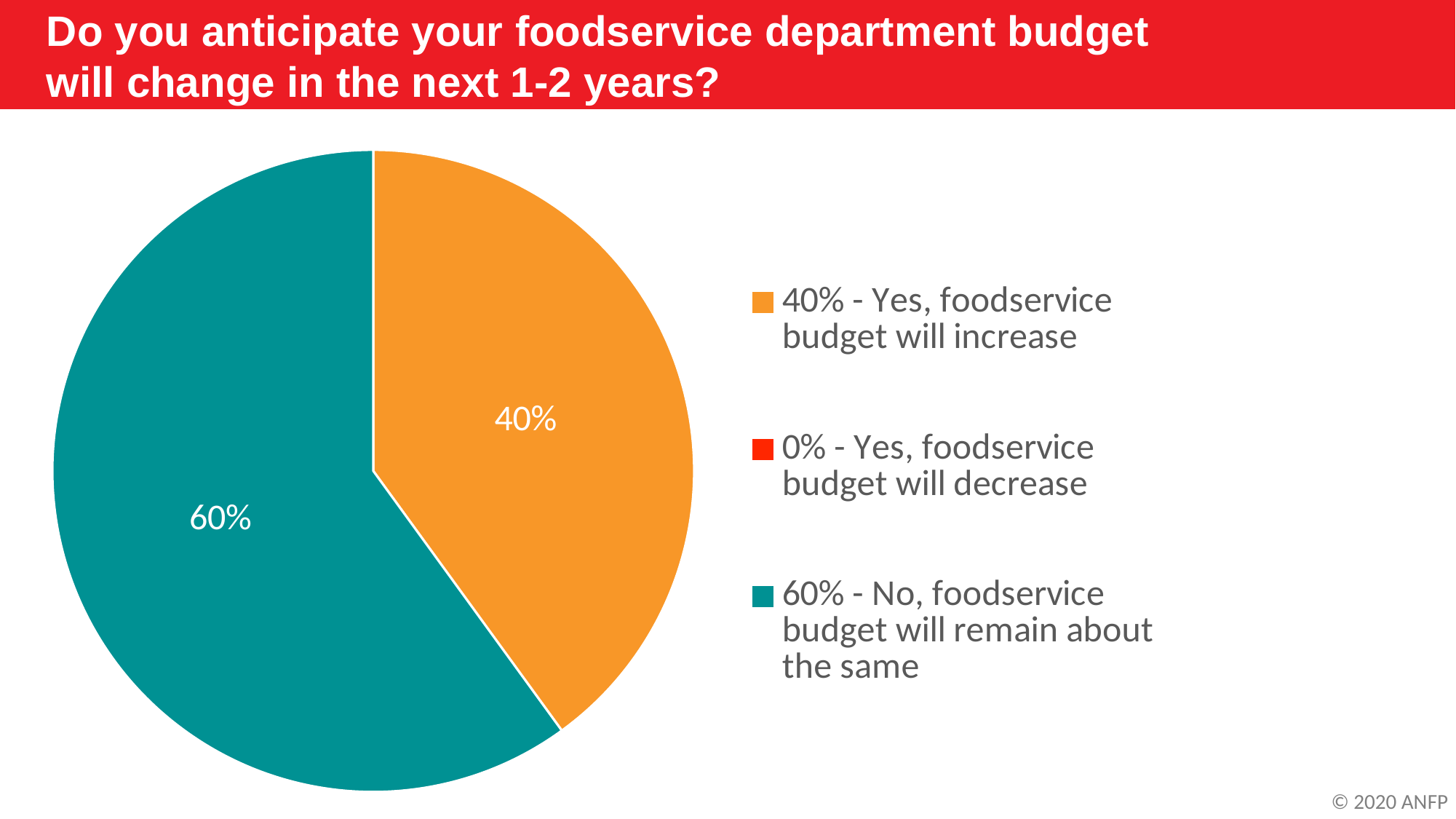
What share of respondents said their foodservice budget will remain about the same? 60% What kind of chart is shown on the slide? pie chart Which response has the smallest share of the pie? Yes, foodservice budget will decrease What colour is the slice for 'No, foodservice budget will remain about the same'? teal What share of respondents said their foodservice budget will decrease? 0% Is the share for 'budget will increase' greater or less than 50%? less Which is larger: the share for 'budget will increase' or the share for 'budget will remain about the same'? budget will remain about the same Which response has the largest share of the pie? No, foodservice budget will remain about the same What is the difference in percentage points between the 'remain about the same' and 'will increase' responses? 20 percentage points What colour is the slice for 'Yes, foodservice budget will increase'? orange What share of respondents said their foodservice budget will increase? 40% How many response categories does the legend list? 3